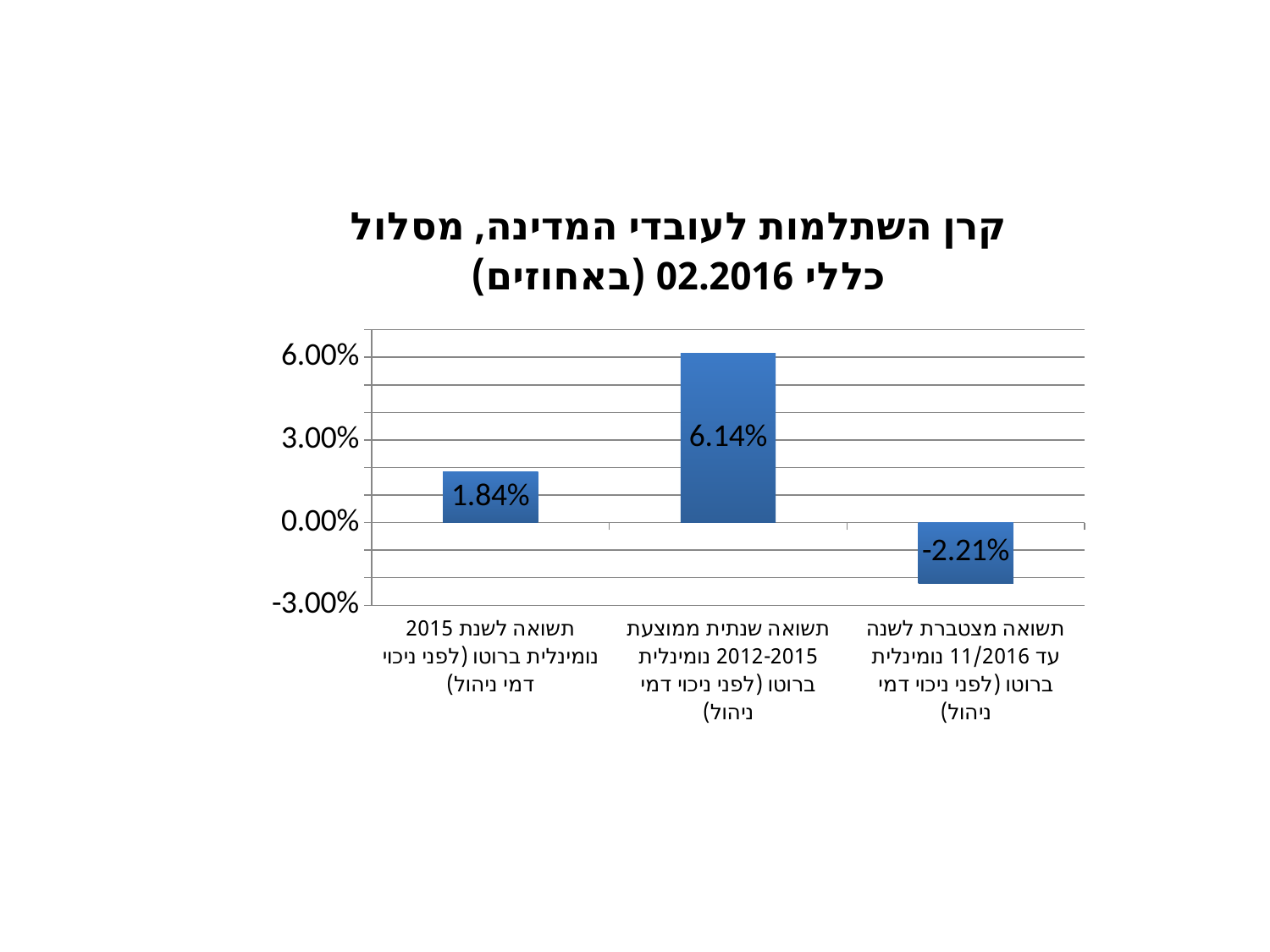
What is the value for the 2015 return (תשואה לשנת 2015)? 1.84% What is the title of the chart? קרן השתלמות לעובדי המדינה, מסלול כללי 02.2016 (באחוזים) What is the difference between the average annual return 2012-2015 (6.14%) and the 2015 return (1.84%)? 4.30% How many categories (bars) are shown in the chart? 3 What kind of chart is shown on the slide? Bar chart Which is larger: the 2015 return or the cumulative return to 11/2016? The 2015 return (1.84%) Which category has the lowest value? תשואה מצטברת לשנה עד 11/2016 נומינלית ברוטו (לפני ניכוי דמי ניהול) Which category has the highest value? תשואה שנתית ממוצעת 2012-2015 נומינלית ברוטו (לפני ניכוי דמי ניהול) What is the value for the average annual return 2012-2015 (תשואה שנתית ממוצעת 2012-2015)? 6.14% Is the value for the average annual return 2012-2015 greater or less than 3.00%? greater How many bars have a negative value? 1 What is the value for the cumulative return for the year to 11/2016 (תשואה מצטברת לשנה עד 11/2016)? -2.21%